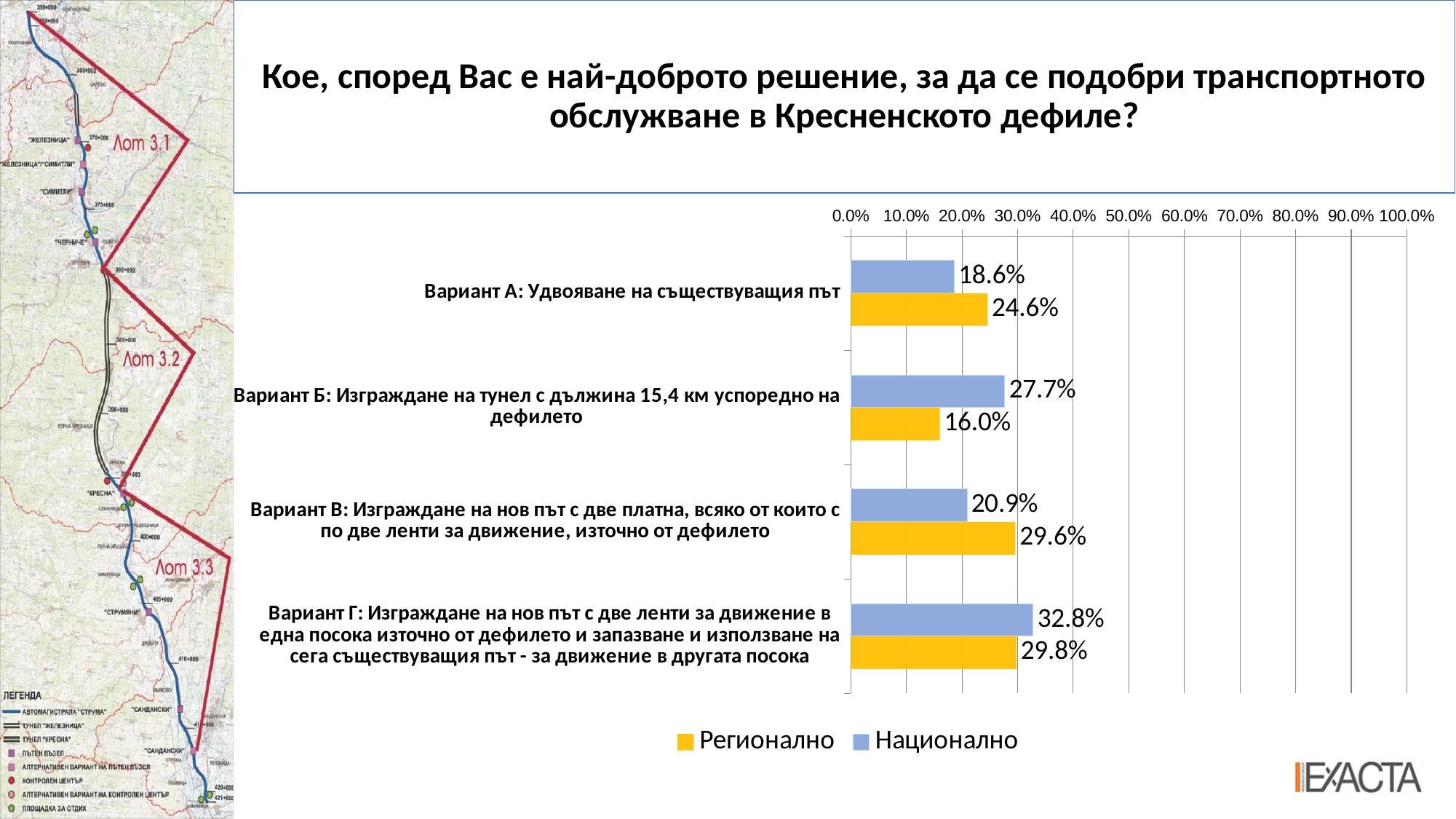
What type of chart is shown on the slide? Bar chart What is the Национално value for Вариант А: Удвояване на съществуващия път? 18.6% What is the difference between the Регионално and Национално values for Вариант Б? 11.7% Which variant has the highest Национално value? Вариант Г How many variants (categories) are shown in the chart? 4 How many series does the legend list? 2 Which variant has the lowest Регионално value? Вариант Б What is the Регионално value for Вариант Б: Изграждане на тунел с дължина 15,4 км успоредно на дефилето? 16.0% Is the Национално value for Вариант Г greater or less than 30.0%? greater For Вариант А, which is larger: the Регионално value or the Национално value? Регионално What is the Регионално value for Вариант В: Изграждане на нов път с две платна, всяко от които с по две ленти за движение, източно от дефилето? 29.6% What is the Национално value for Вариант Г? 32.8%